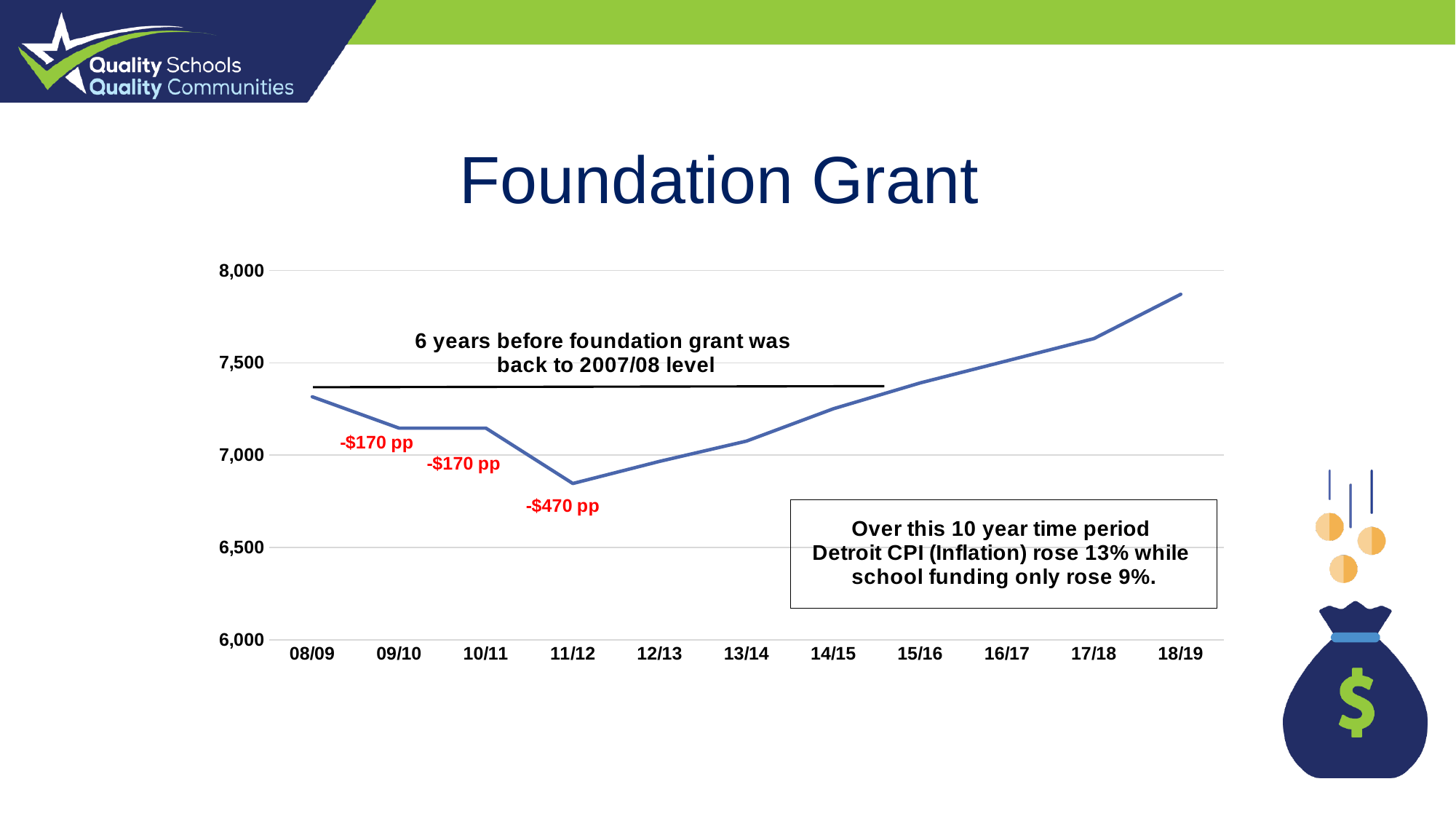
Do the foundation grant values rise or fall from 11/12 to 18/19? rise Which school year has the highest foundation grant value on the chart? 18/19 Is the foundation grant value for 11/12 greater or less than 7,000? less How many school years are plotted along the x axis of the Foundation Grant chart? 11 What change is annotated in red on the chart for the drop between 10/11 and 11/12? -$470 pp Is the foundation grant value for 13/14 greater or less than 7,000? greater Is the foundation grant value for 18/19 greater or less than 7,500? greater Which school year has the larger foundation grant value, 08/09 or 18/19? 18/19 What is the title of the chart on the slide? Foundation Grant Which school year has the lowest foundation grant value on the chart? 11/12 What kind of chart is shown on the slide? line chart